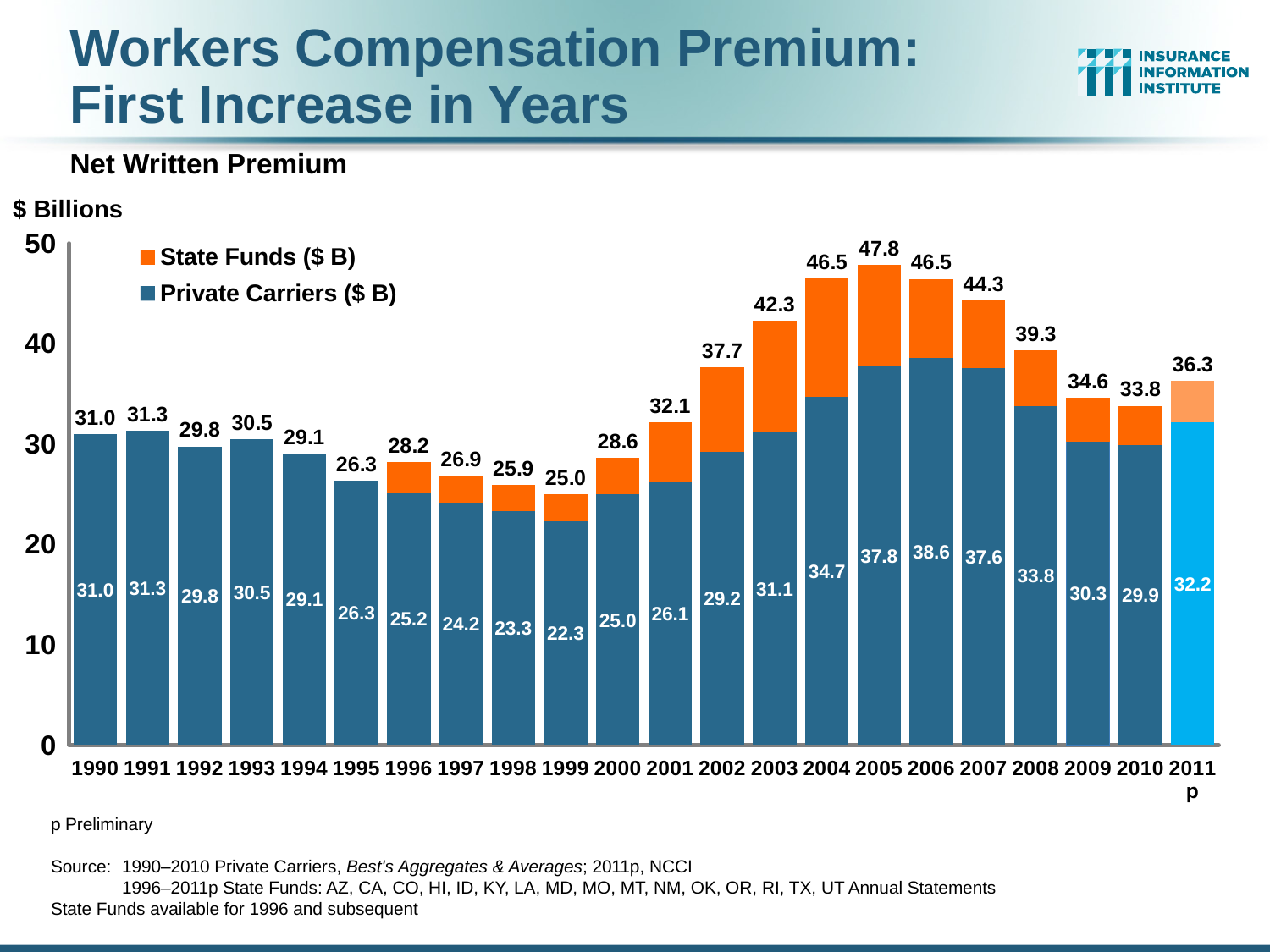
Which year has the lowest total net written premium? 1999 What is the total net written premium shown for 2005? 47.8 Which year has the highest total net written premium? 2005 How many years are shown on the x axis? 22 What is the State Funds portion for 2005 (total minus Private Carriers)? 10.0 What is the total net written premium shown for 2008? 39.3 What is the Private Carriers value for 2006? 38.6 Which year has the larger total net written premium, 2003 or 2007? 2007 By how much does the total for 2011p exceed the total for 2010? 2.5 What kind of chart is shown on the slide? bar chart Which year has the lowest Private Carriers value? 1999 How many series does the legend list? 2